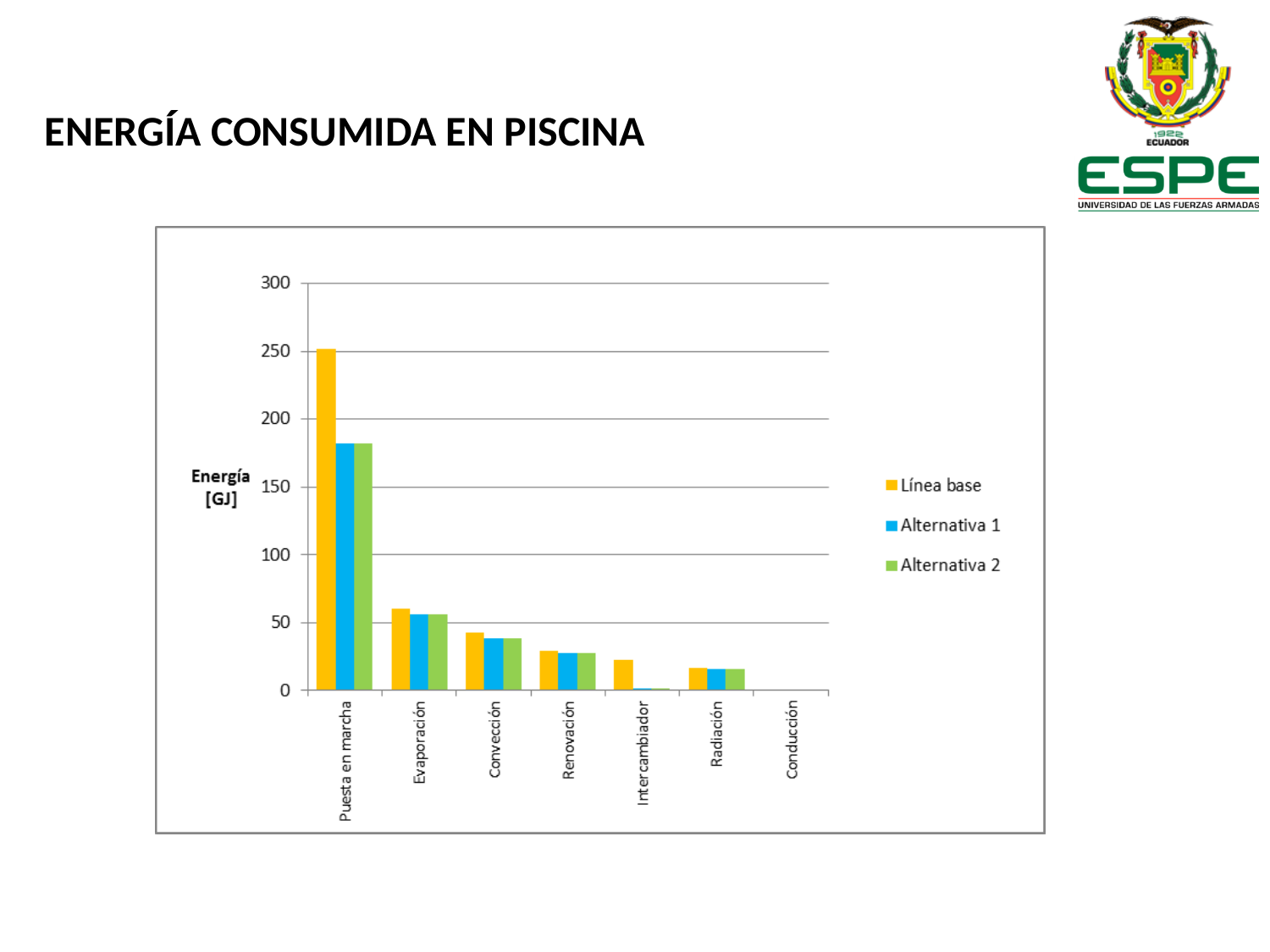
How many categories are shown on the x axis of the chart? 7 Is the Línea base value for Evaporación greater or less than 50? greater For Intercambiador, which is larger: the Línea base value or the Alternativa 1 value? Línea base Which category has the highest Línea base value? Puesta en marcha What kind of chart is shown on the slide? bar chart Which category has the lowest Línea base value? Conducción Is the Alternativa 1 value for Puesta en marcha greater or less than 200? less Do the Línea base values rise or fall moving from left to right along the x axis? fall Is the Línea base value for Convección greater or less than 50? less What is the label of the vertical axis of the chart? Energía [GJ] How many series does the chart's legend list? 3